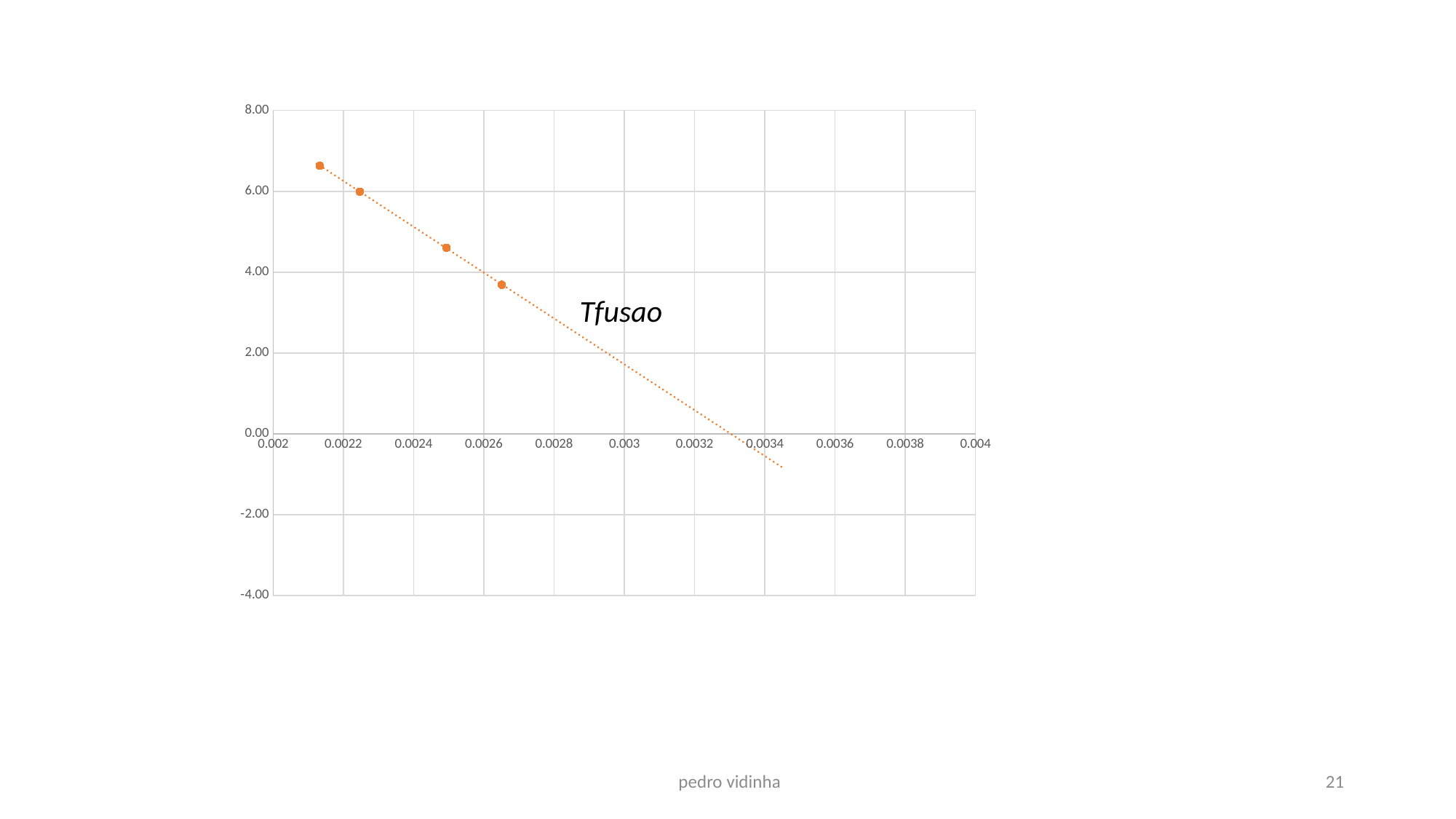
Is the y value of the rightmost data point greater or less than 4.00? less Do the plotted values rise or fall as the x value increases? fall How many data points are plotted on the chart? 4 Is the y value of the rightmost data point greater or less than 2.00? greater Which data point has the higher y value, the leftmost or the rightmost? the leftmost What text label is written next to the trendline on the chart? Tfusao Is the x value of the rightmost data point greater or less than 0.0028? less What kind of chart is shown on the slide? scatter chart What colour are the data points on the chart? orange